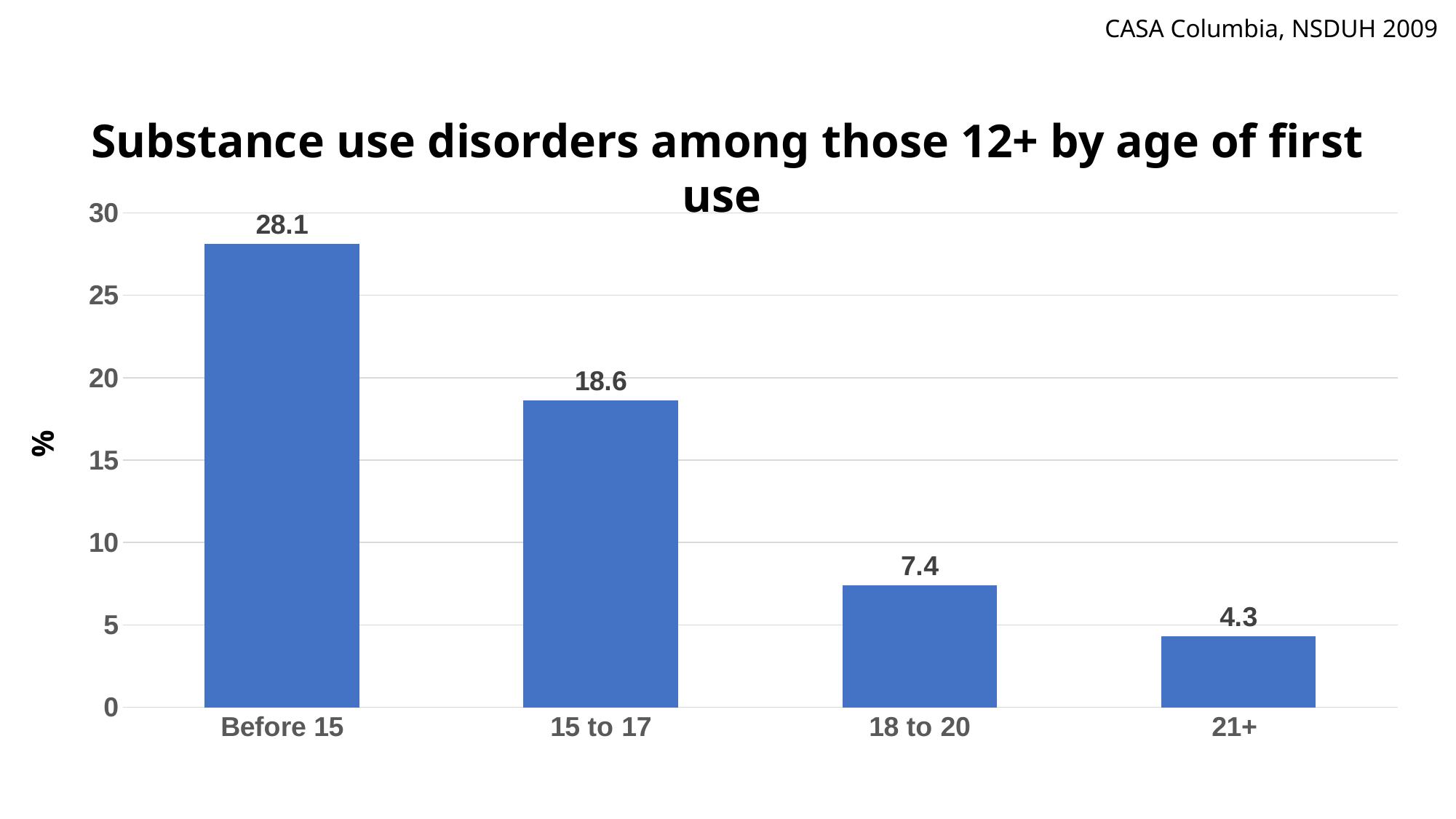
How many age categories are shown on the x axis? 4 What is the value for the '21+' category? 4.3 What is the difference between the values for '18 to 20' and '21+'? 3.1 What is the value for the '18 to 20' category? 7.4 What is the difference between the values for 'Before 15' and '15 to 17'? 9.5 What is the value for the 'Before 15' category? 28.1 Which age of first use category has the highest value? Before 15 What kind of chart is shown on the slide? Bar chart Do the values rise or fall moving from left to right along the x axis? Fall What is the value for the '15 to 17' category? 18.6 Which age of first use category has the lowest value? 21+ Which is larger, the value for '15 to 17' or the value for '18 to 20'? 15 to 17